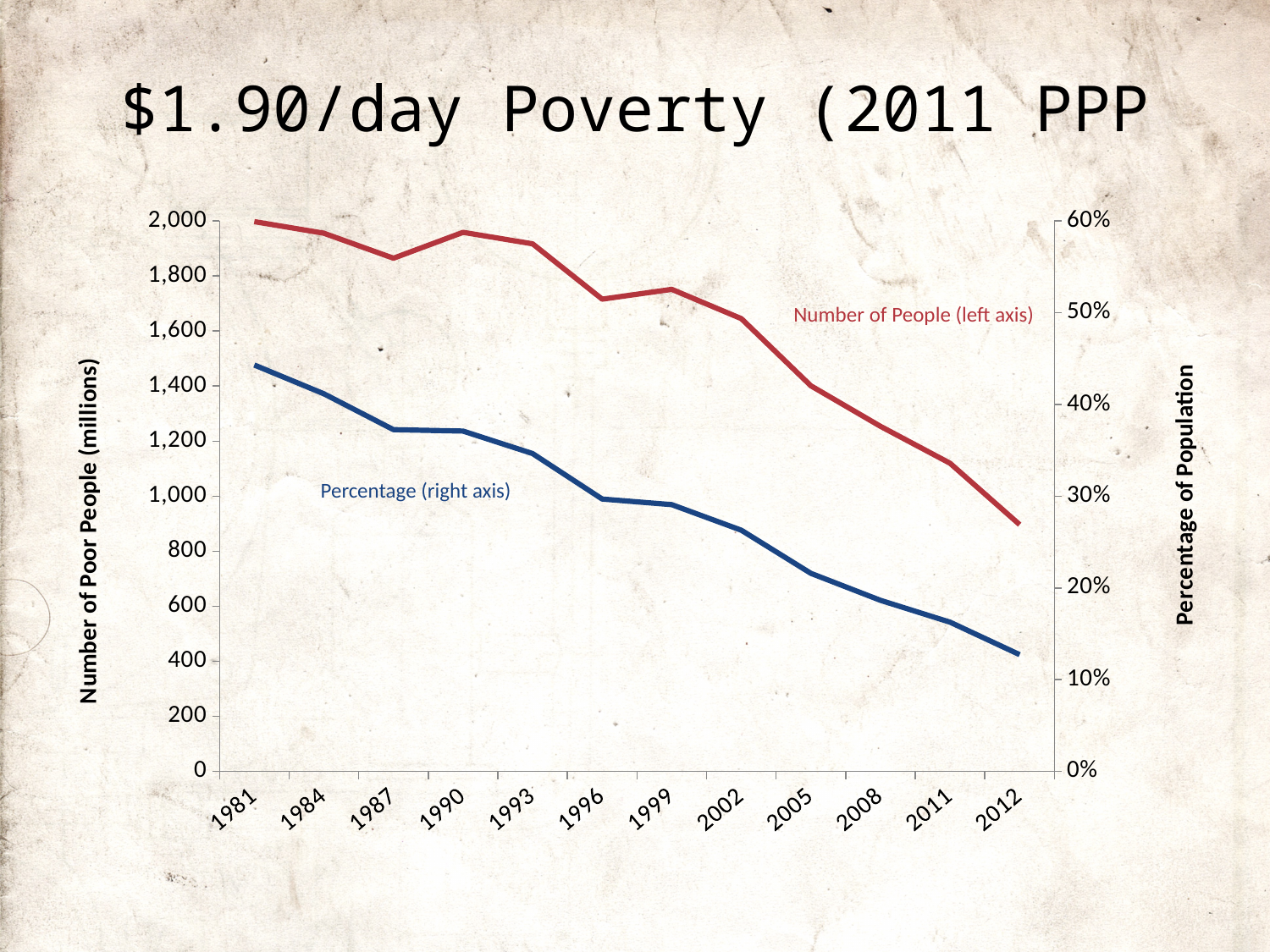
What is the label of the left vertical axis? Number of Poor People (millions) Is the Percentage in 2012 greater or less than 20%? less Is the Number of People in 1981 greater or less than 1,800? greater How many series are plotted on the chart? 2 How many years are shown along the x axis? 12 In which year is the Percentage lowest? 2012 Is the Percentage in 1981 greater or less than 40%? greater Does the Number of People series rise or fall from 1981 to 2012? fall Does the Percentage series rise or fall across the years shown? fall What kind of chart is shown on the slide? line chart In which year is the Number of People highest? 1981